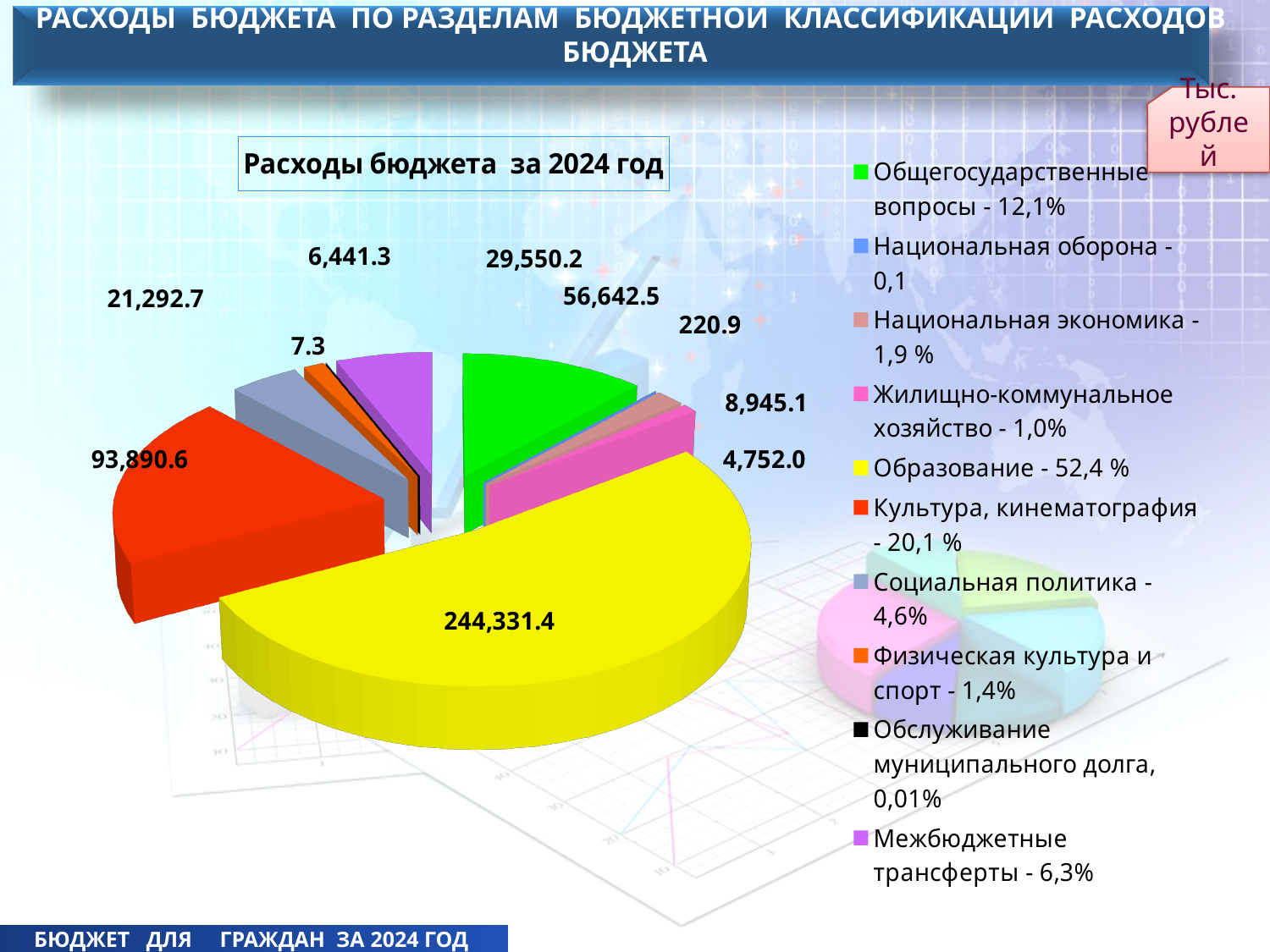
What kind of chart is shown on the slide? pie chart What is the title of the chart? Расходы бюджета за 2024 год What share of the pie does Социальная политика account for, according to the legend? 4,6% Which is larger: the Культура, кинематография slice or the Общегосударственные вопросы slice? Культура, кинематография What is the value shown for the Культура, кинематография slice? 93,890.6 How many categories does the chart's legend list? 10 Which category has the smallest share of the pie? Обслуживание муниципального долга What is the value shown for the Общегосударственные вопросы slice? 56,642.5 What is the value shown for the Образование slice? 244,331.4 What is the difference between the Образование value and the Культура, кинематография value? 150,440.8 What share of the pie does Образование account for, according to the legend? 52,4 % Which category has the largest share of the pie? Образование